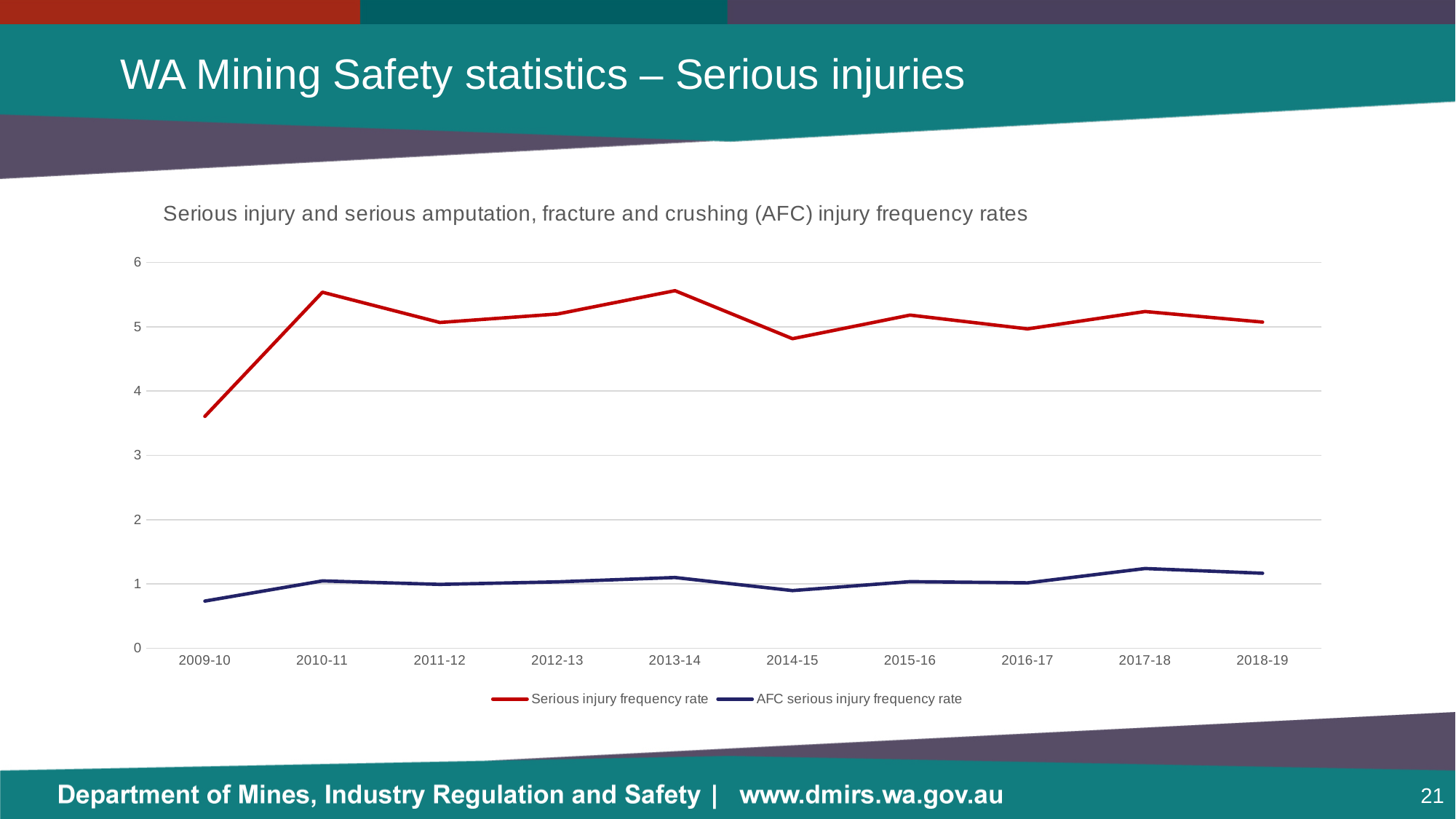
How many years are shown along the x axis? 10 Which year has the lowest Serious injury frequency rate? 2009-10 Is the Serious injury frequency rate for 2010-11 greater or less than 5? greater Is the Serious injury frequency rate for 2009-10 greater or less than 4? less Which colour is used for the AFC serious injury frequency rate line? Dark blue What kind of chart is shown on the slide? Line chart Which is larger, the Serious injury frequency rate in 2009-10 or in 2010-11? 2010-11 How many series does the legend list? 2 Which year has the highest AFC serious injury frequency rate? 2017-18 Does the Serious injury frequency rate rise or fall from 2009-10 to 2010-11? Rise Which year has the lowest AFC serious injury frequency rate? 2009-10 Is the AFC serious injury frequency rate for 2014-15 greater or less than 1? less